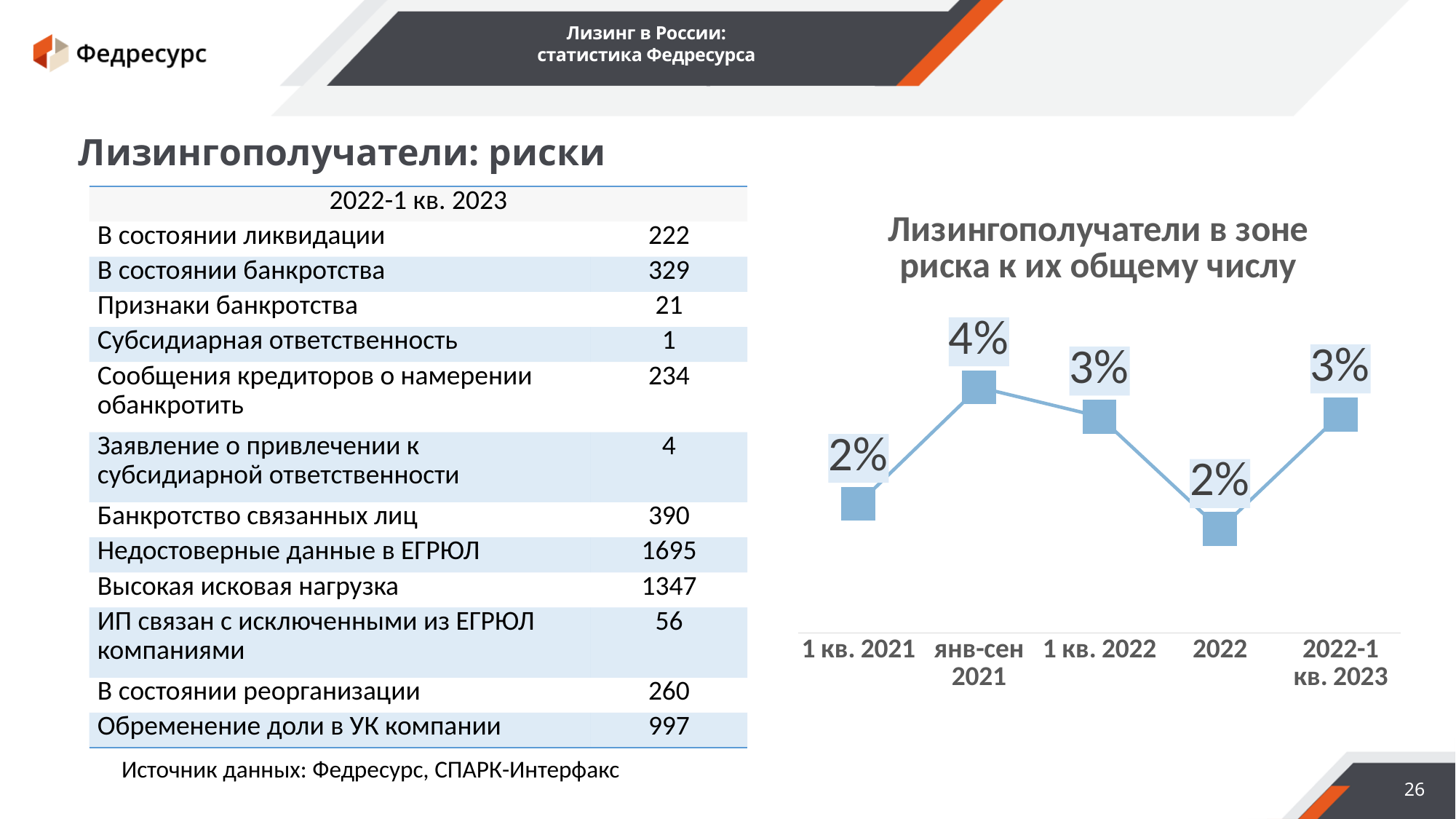
What is the title of the chart? Лизингополучатели в зоне риска к их общему числу What is the value for 1 кв. 2021 in the chart? 2% Which is larger in the chart: the value for янв-сен 2021 or the value for 1 кв. 2022? янв-сен 2021 What is the value for 1 кв. 2022 in the chart? 3% How many data points are plotted in the chart? 5 What kind of chart is shown on the slide? line chart Which period has the highest value in the chart? янв-сен 2021 What is the value for янв-сен 2021 in the chart? 4% What is the difference between the value for янв-сен 2021 and the value for 2022 in the chart? 2% Does the value rise or fall from 1 кв. 2022 to 2022 in the chart? fall What is the value for 2022 in the chart? 2% What is the value for 2022-1 кв. 2023 in the chart? 3%